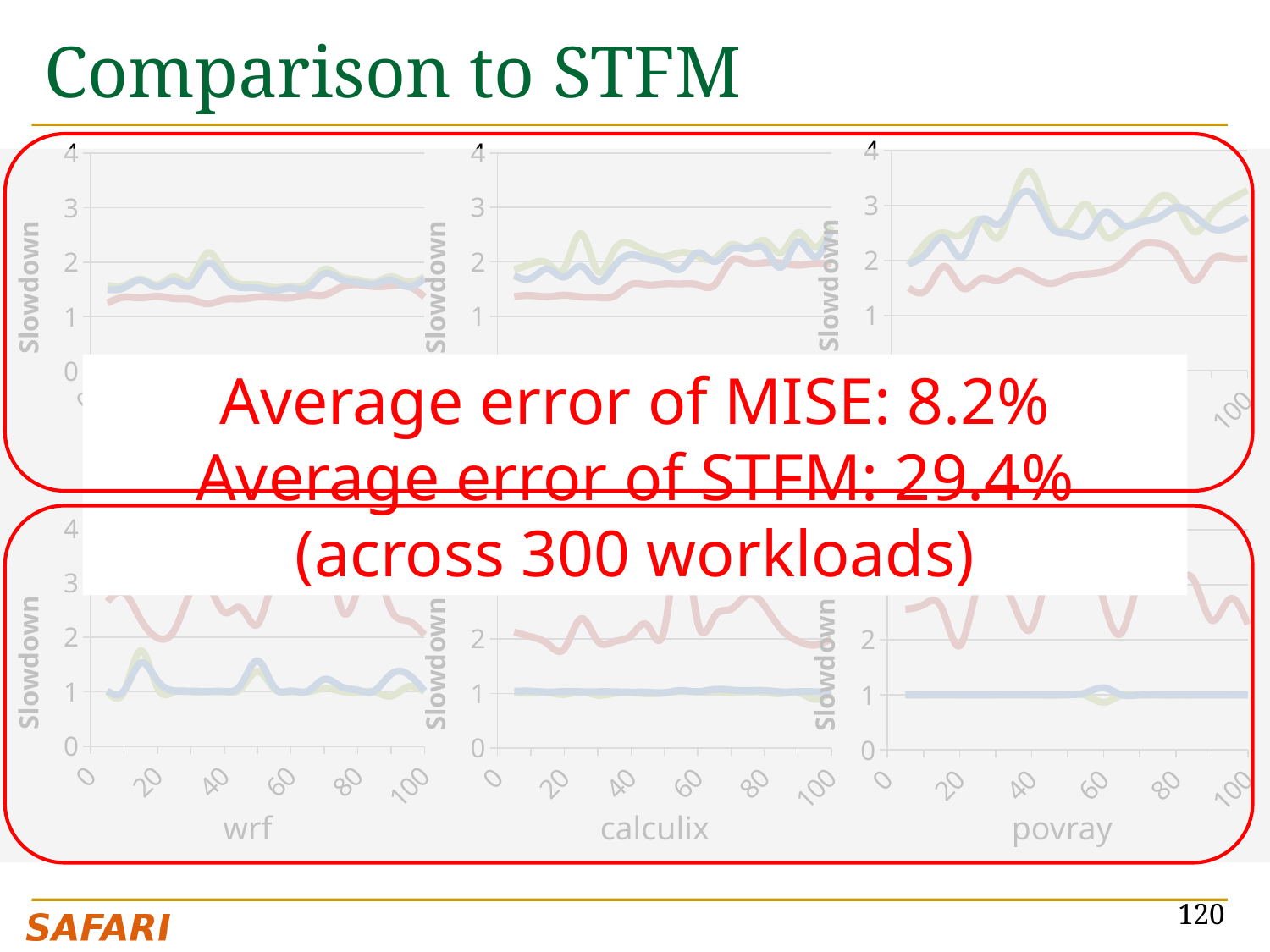
In the top-right chart, is the green line's value at x=40 greater or less than 3? greater In the top-middle chart, is the red line's value at x=20 greater or less than 2? less How many chart panels are shown on the slide? 6 What kind of chart is used in each of the six panels on the slide? line chart In the bottom-left chart labeled wrf, is the red line's value at x=40 greater or less than 2? greater In the top-middle chart, does the red line generally rise or fall from x=0 to x=100? rise In the bottom-left chart labeled wrf, at x=40, which line has the larger value, the red line or the blue line? red line What are the labels under the three bottom-row charts, from left to right? wrf, calculix, povray What is the y-axis label on the charts? Slowdown